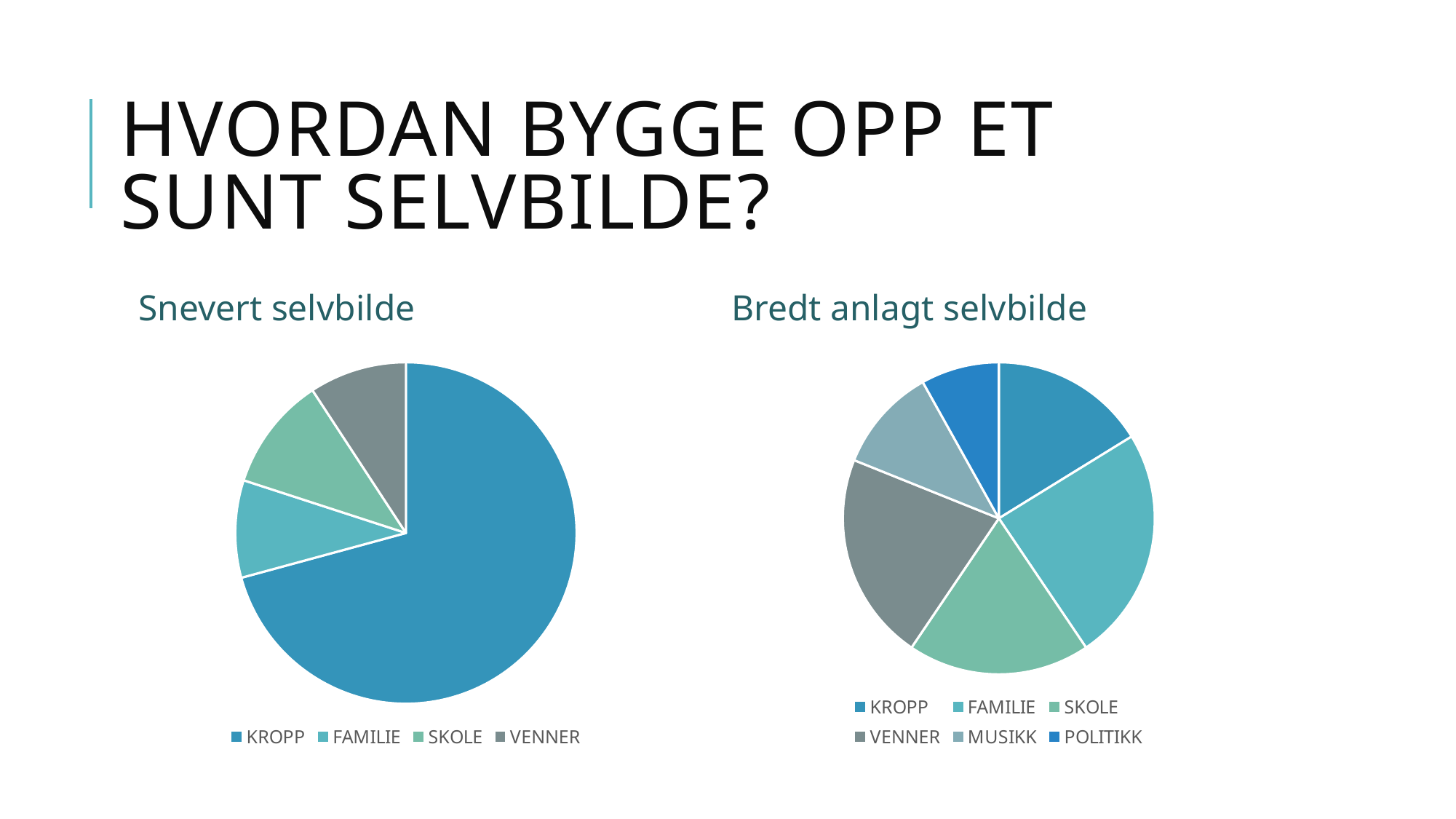
In the "Snevert selvbilde" chart, which slice is larger, KROPP or FAMILIE? KROPP What is the title of the pie chart on the left of the slide? Snevert selvbilde In the "Snevert selvbilde" chart, which category has the largest slice? KROPP In the "Bredt anlagt selvbilde" chart, which slice is larger, FAMILIE or POLITIKK? FAMILIE In the "Bredt anlagt selvbilde" chart, which category has the smallest slice? POLITIKK In the "Snevert selvbilde" chart, how many slices does the pie have? 4 In the "Bredt anlagt selvbilde" chart, how many slices does the pie have? 6 How many entries does the legend of the "Bredt anlagt selvbilde" chart list? 6 What kind of chart is the "Bredt anlagt selvbilde" chart? pie chart What kind of chart is the "Snevert selvbilde" chart? pie chart Which two categories appear in the legend of the "Bredt anlagt selvbilde" chart but not in the "Snevert selvbilde" chart? MUSIKK and POLITIKK In the "Bredt anlagt selvbilde" chart, which slice is larger, VENNER or MUSIKK? VENNER